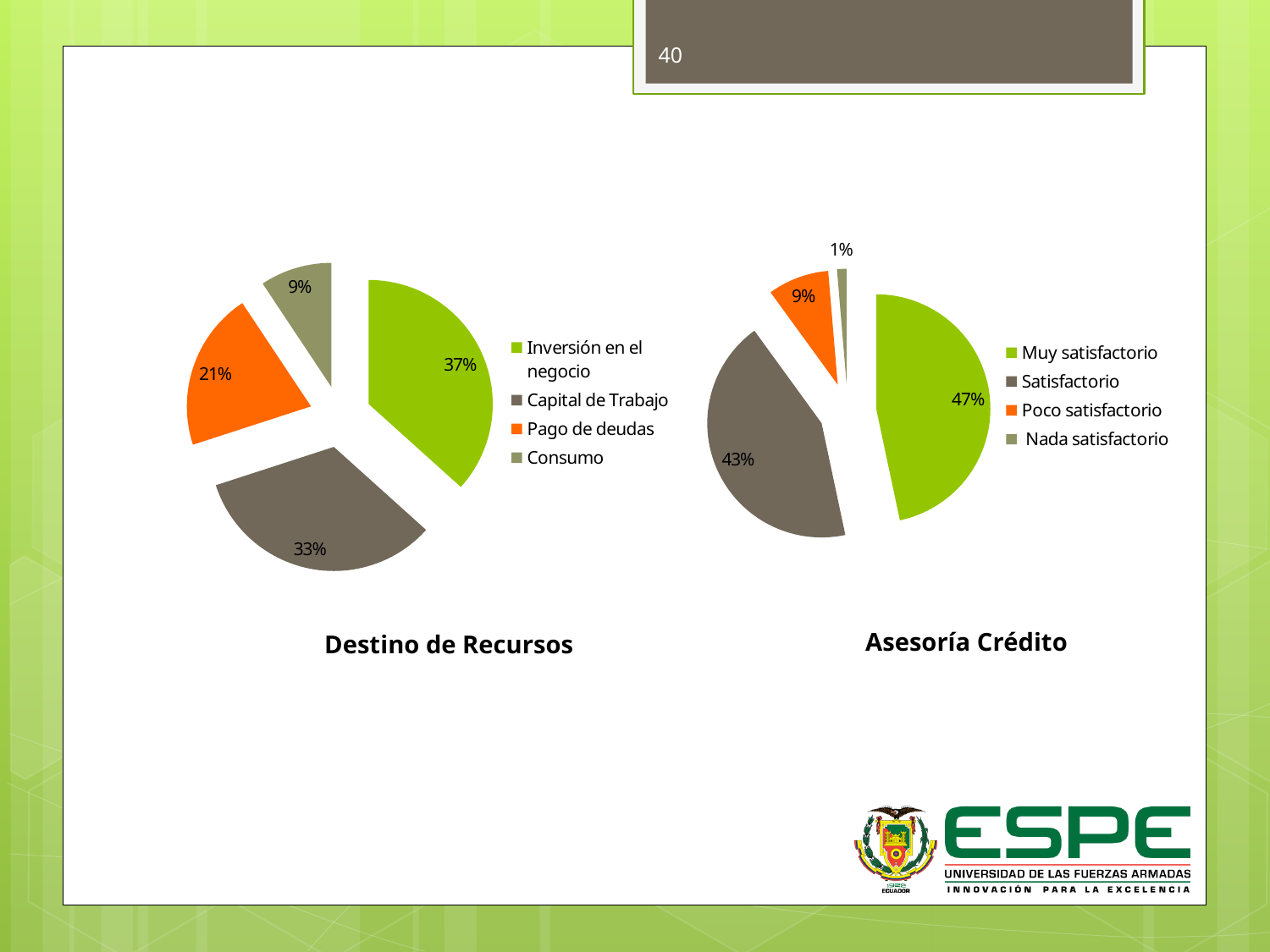
In the 'Asesoría Crédito' chart, what share is labelled for Nada satisfactorio? 1% In the 'Destino de Recursos' chart, which category has the smallest slice? Consumo In the 'Asesoría Crédito' chart, what share is labelled for Satisfactorio? 43% In the 'Asesoría Crédito' chart, which category has the largest slice? Muy satisfactorio In the 'Asesoría Crédito' chart, what colour is the Poco satisfactorio slice? Orange In the 'Destino de Recursos' chart, how many categories does the legend list? 4 In the 'Destino de Recursos' chart, what share is labelled for Pago de deudas? 21% In the 'Destino de Recursos' chart, which category has the largest slice? Inversión en el negocio In the 'Destino de Recursos' chart, what is the difference in percentage points between Capital de Trabajo and Pago de deudas? 12 In the 'Asesoría Crédito' chart, which is larger, Poco satisfactorio or Nada satisfactorio? Poco satisfactorio What kind of chart is the 'Asesoría Crédito' chart? Pie chart In the 'Destino de Recursos' chart, what share is labelled for Inversión en el negocio? 37%